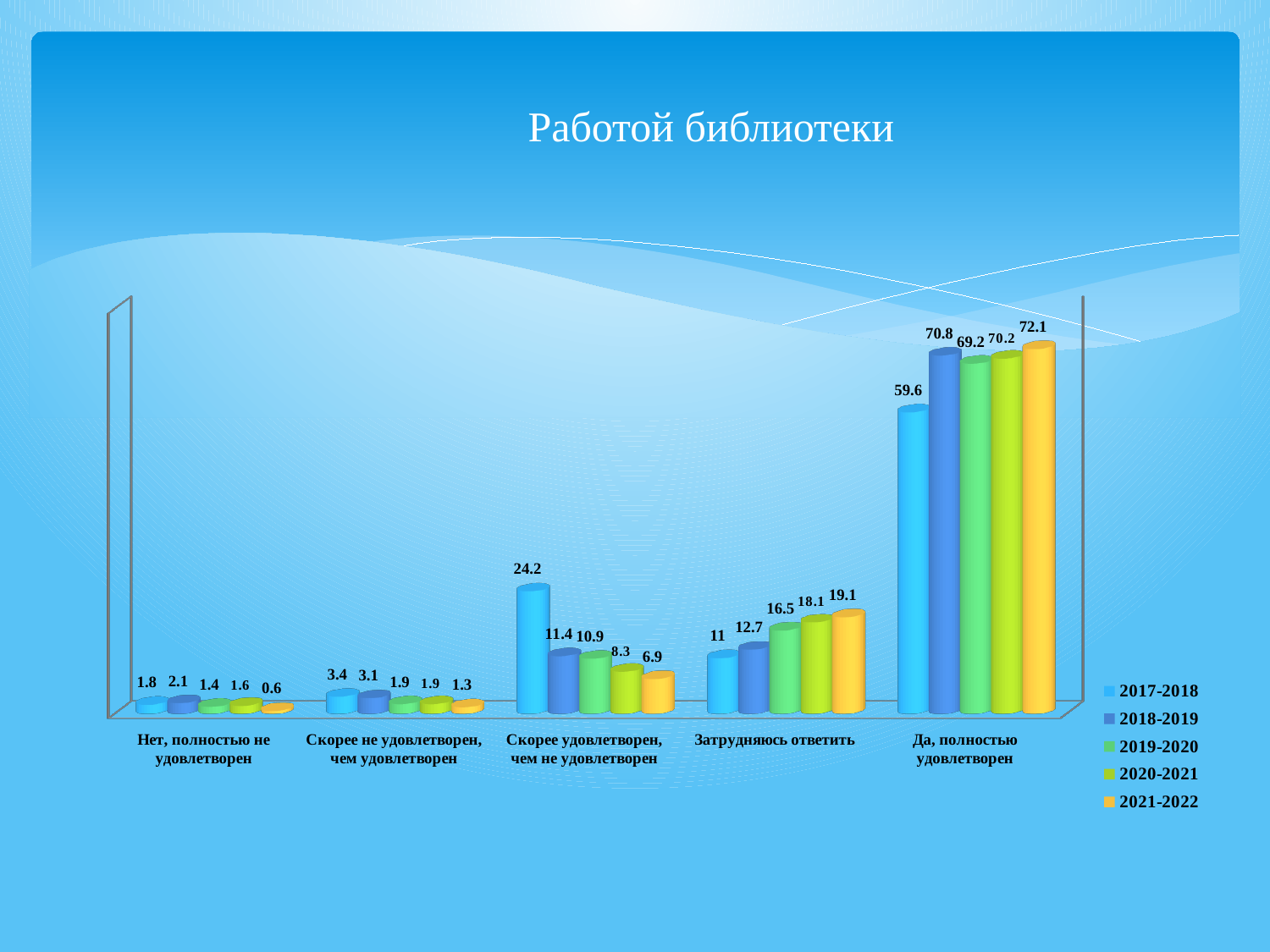
How many series does the legend list? 5 What kind of chart is shown on the slide? Bar chart What is the difference between the 2017-2018 and 2018-2019 values in the category "Да, полностью удовлетворен"? 11.2 How many categories are shown on the x axis? 5 Which series has the highest value in the category "Да, полностью удовлетворен"? 2021-2022 What is the value for 2017-2018 in the category "Скорее удовлетворен, чем не удовлетворен"? 24.2 What is the value for 2021-2022 in the category "Да, полностью удовлетворен"? 72.1 What is the value for 2019-2020 in the category "Затрудняюсь ответить"? 16.5 Do the values in the category "Затрудняюсь ответить" rise or fall from 2017-2018 to 2021-2022? Rise What is the title of the chart? Работой библиотеки Which is larger in the category "Затрудняюсь ответить": the value for 2018-2019 or the value for 2020-2021? 2020-2021 Which series has the lowest value in the category "Нет, полностью не удовлетворен"? 2021-2022